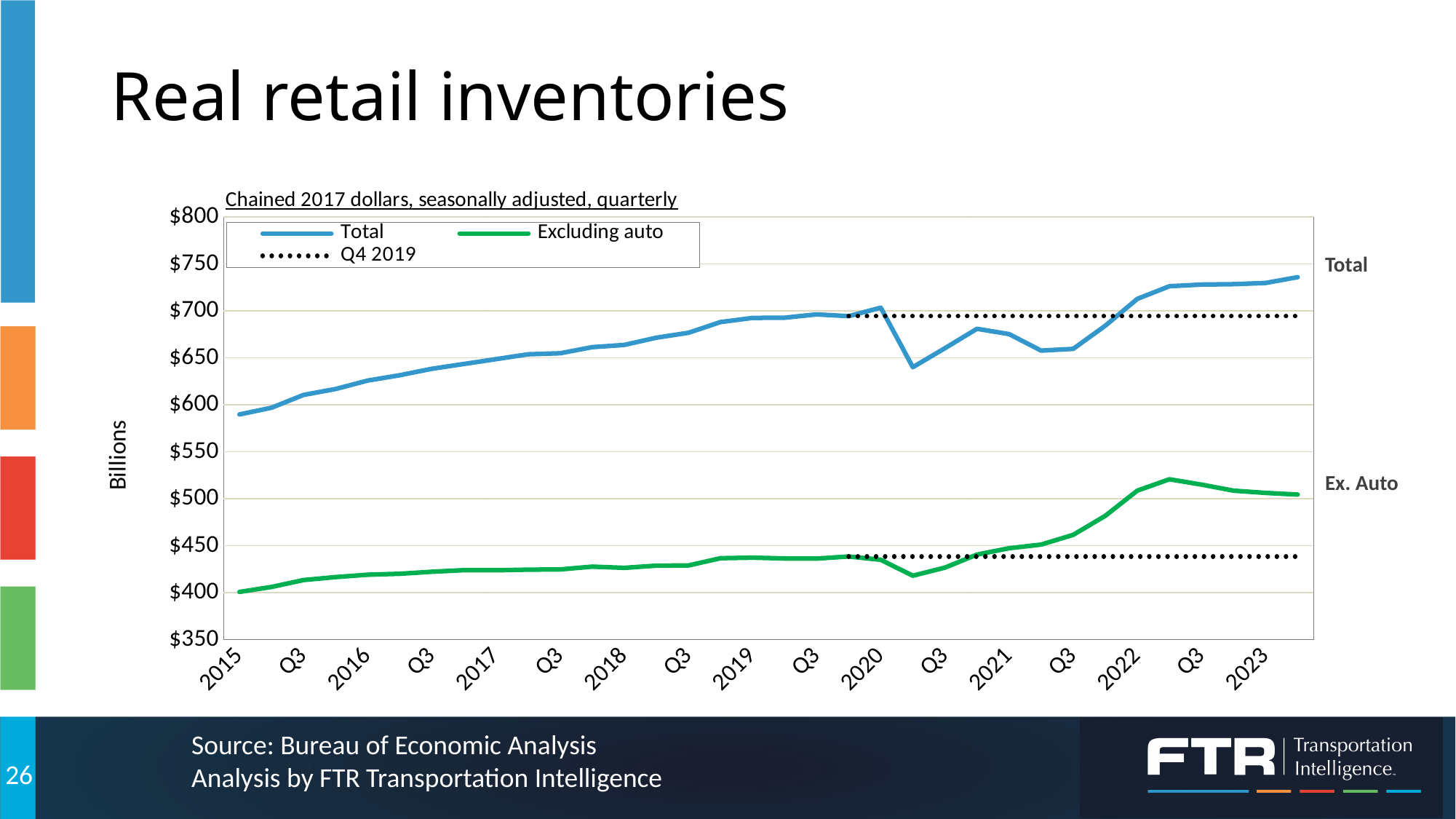
What kind of chart is shown on the slide? line chart What is the title of the slide? Real retail inventories Is the value of the Excluding auto series at the start of 2019 greater or less than $450? less At which point on the x axis is the Total series at its lowest? 2015 Which series has higher values throughout the chart, Total or Excluding auto? Total Does the Total series rise or fall from 2015 to 2019? rise What is the label on the vertical axis of the chart? Billions Is the peak value of the Excluding auto series in 2022 greater or less than $500? greater Is the value of the Total series at the last point in 2023 greater or less than $700? greater How many entries does the chart legend list? 3